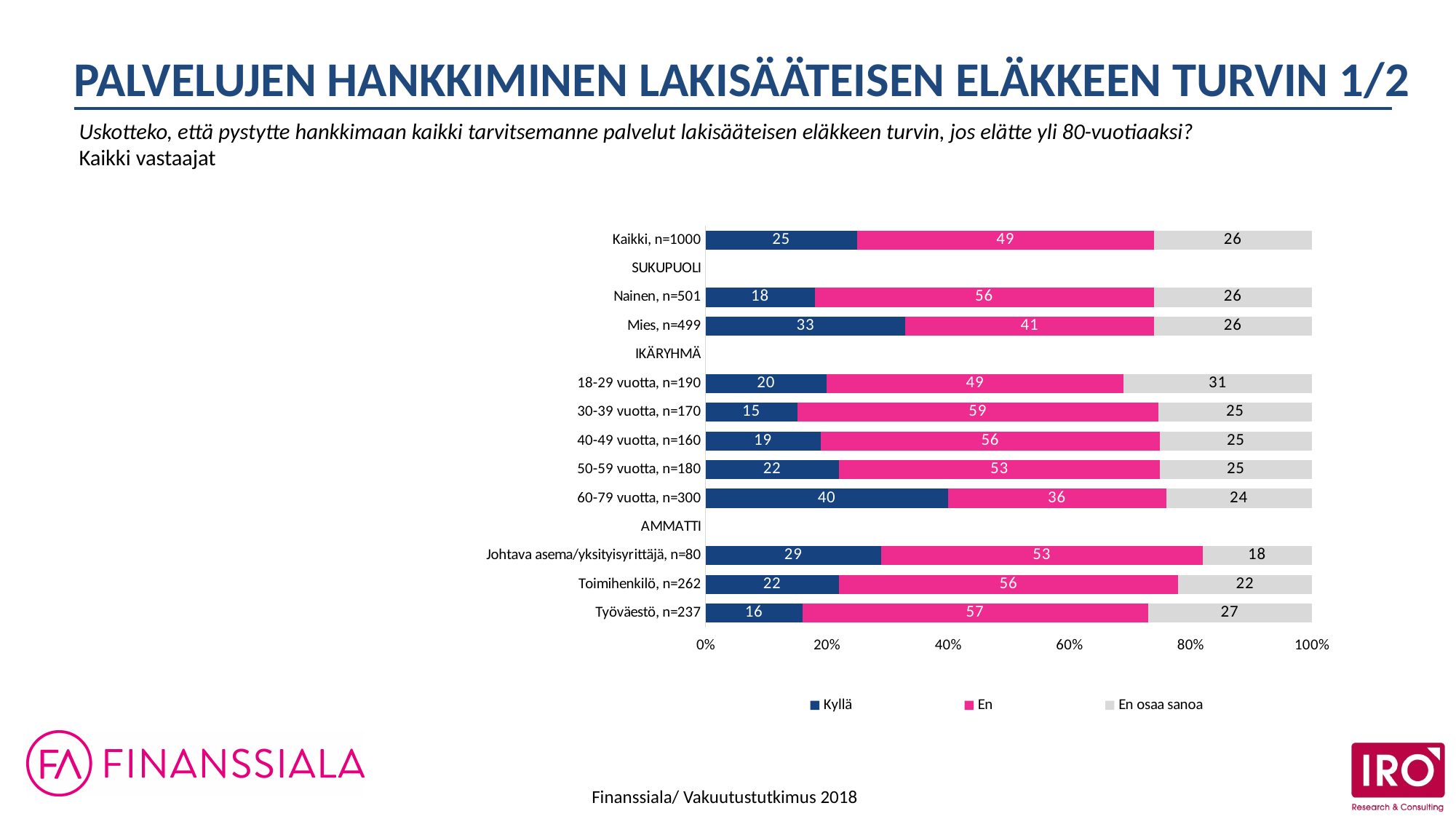
What is the total of the stacked bar for Johtava asema/yksityisyrittäjä, n=80? 100 What is the En osaa sanoa value for 18-29 vuotta, n=190? 31 What is the Kyllä value for Kaikki, n=1000? 25 Which category has the highest Kyllä value? 60-79 vuotta, n=300 Which category has the lowest Kyllä value? 30-39 vuotta, n=170 What is the difference between the Kyllä values for Mies, n=499 and Nainen, n=501? 15 Which is larger, the En value for 60-79 vuotta, n=300 or the En value for 30-39 vuotta, n=170? 30-39 vuotta, n=170 How many series does the legend list? 3 Which category has the lowest En osaa sanoa value? Johtava asema/yksityisyrittäjä, n=80 What is the En value for Nainen, n=501? 56 What is the Kyllä value for Työväestö, n=237? 16 What kind of chart is shown on the slide? Stacked bar chart